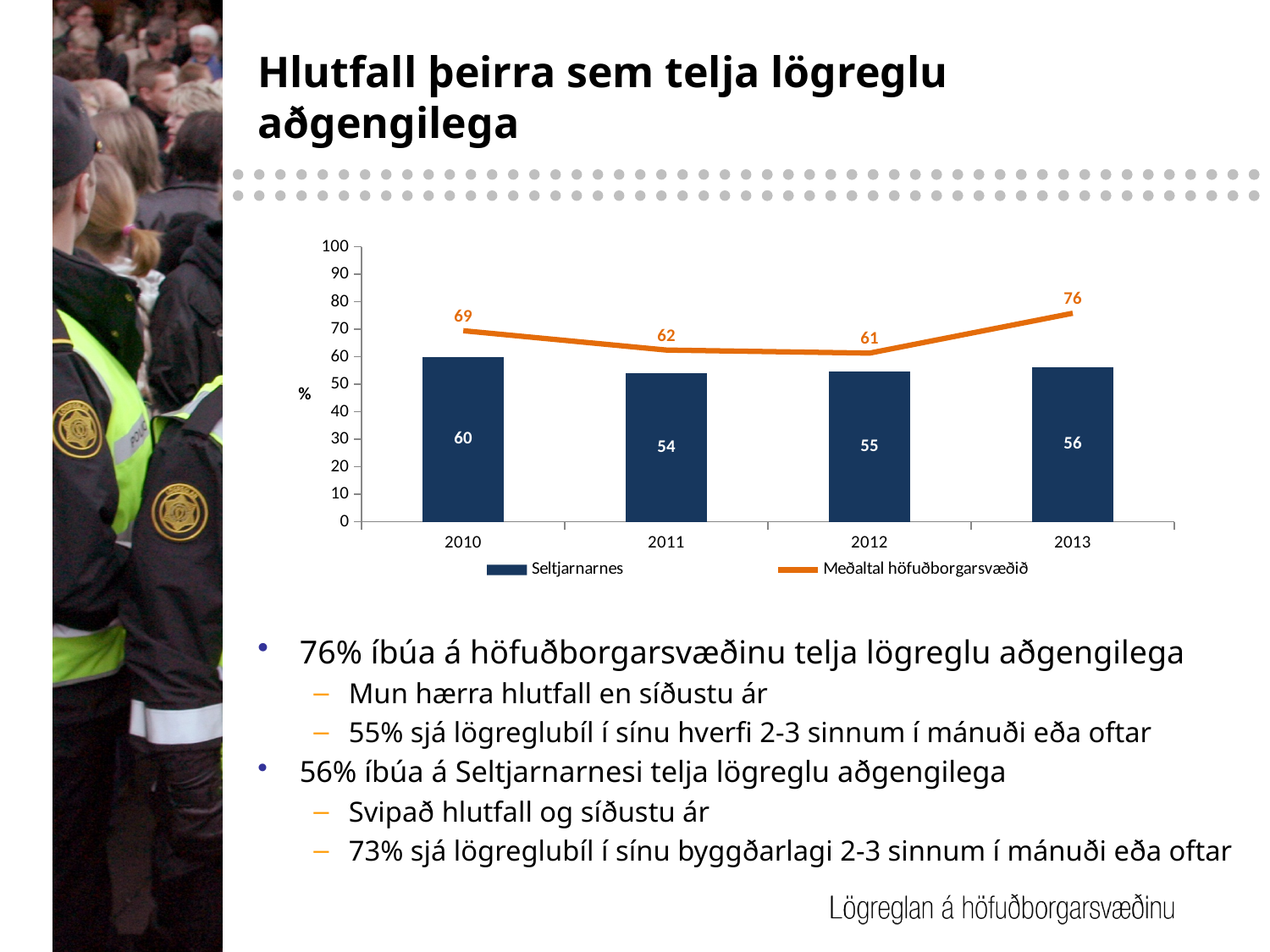
In which year is the Meðaltal höfuðborgarsvæðið line lowest? 2012 Is the value for Seltjarnarnes in 2013 greater or less than 60? less What is the difference between Meðaltal höfuðborgarsvæðið and Seltjarnarnes in 2013? 20 What is the value for Seltjarnarnes in 2011? 54 What is the value for Meðaltal höfuðborgarsvæðið in 2013? 76 In which year is the Seltjarnarnes bar highest? 2010 What is the label on the vertical axis? % Does the Meðaltal höfuðborgarsvæðið line rise or fall from 2012 to 2013? rise Which is larger in 2012: Seltjarnarnes or Meðaltal höfuðborgarsvæðið? Meðaltal höfuðborgarsvæðið How many series does the legend list? 2 How many years are shown on the x axis? 4 What is the value for Seltjarnarnes in 2010? 60